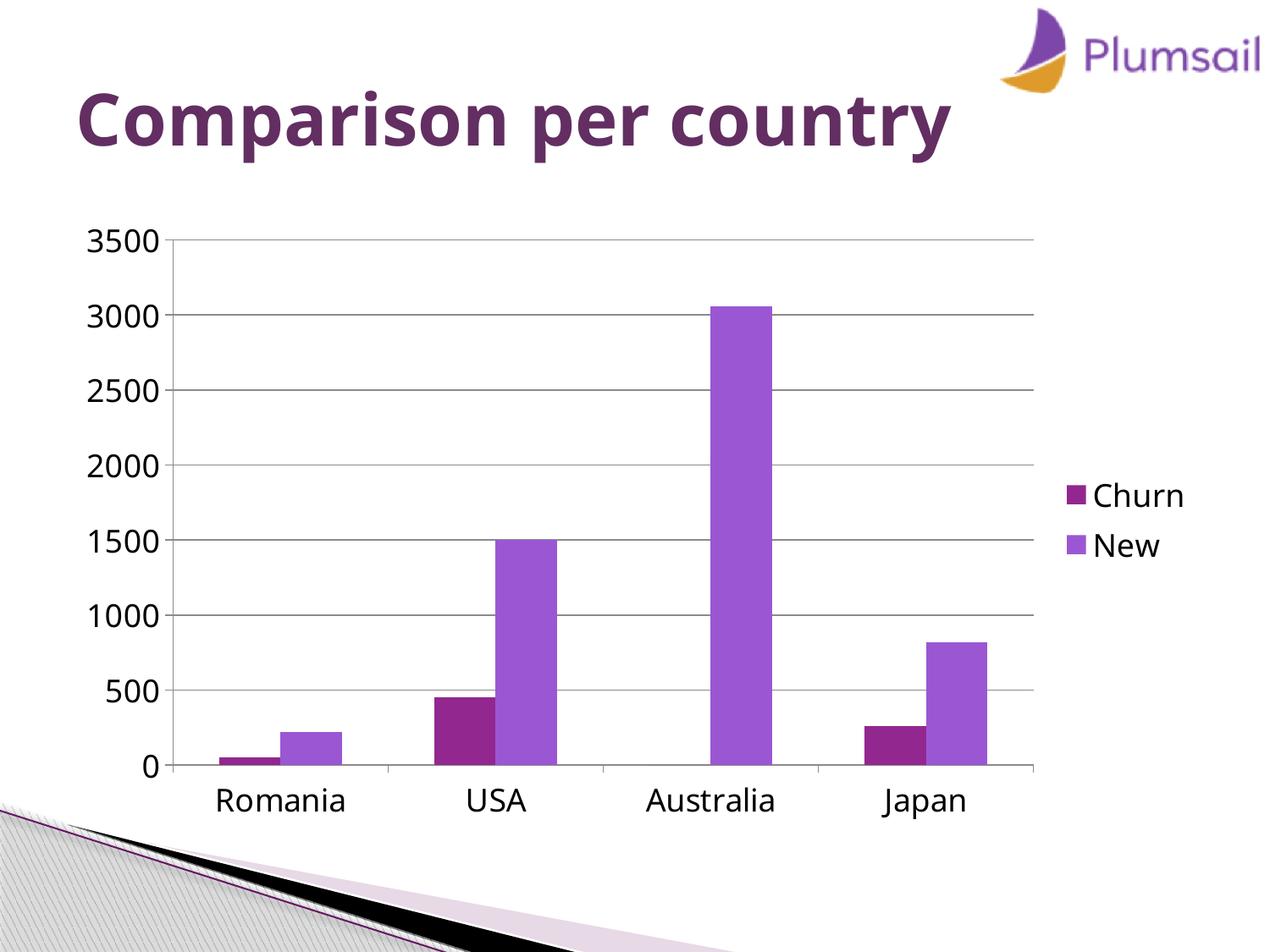
Which country has the lowest New value? Romania Which country has the highest New value? Australia Which is larger, the New value for USA or the New value for Japan? USA How many countries are shown on the x axis of the chart? 4 Is the Churn value for USA greater or less than 500? less What kind of chart is shown on the slide? bar chart Is the New value for Japan greater or less than 1000? less Which is larger, the Churn value for Japan or the Churn value for Romania? Japan What is the title of the slide containing the chart? Comparison per country Which country has the highest Churn value? USA Is the New value for Australia greater or less than 3000? greater How many series does the chart legend list? 2